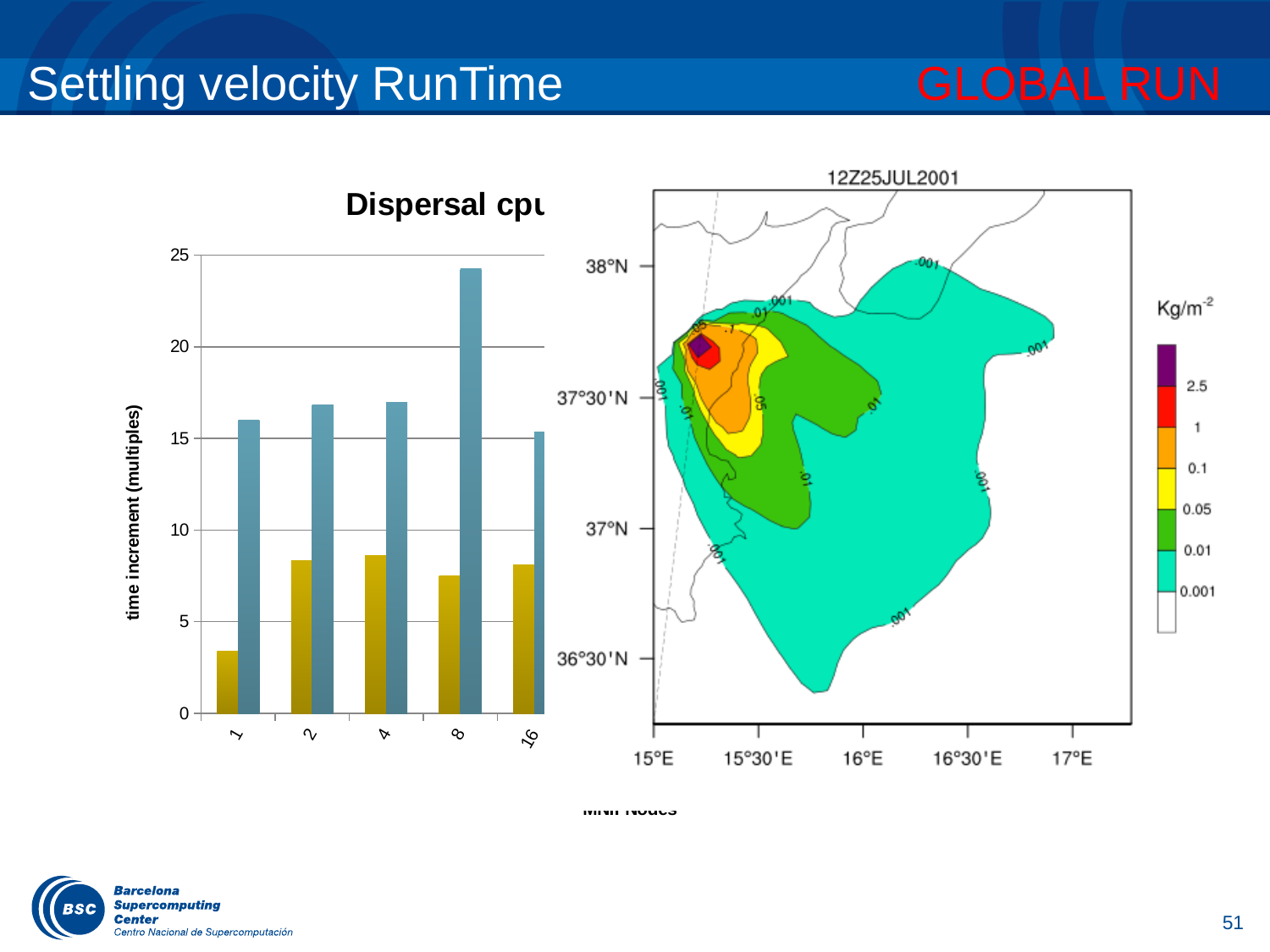
What is the label of the vertical axis of the bar chart? time increment (multiples) How many categories are shown on the x axis of the bar chart? 5 In the bar chart, for which category is the blue bar the tallest? 8 Is the gold bar for category 8 greater or less than 10? less In the bar chart, which gold bar is larger: category 1 or category 2? category 2 In the bar chart, for which category is the gold bar the shortest? 1 In the bar chart, which is larger for category 4: the blue bar or the gold bar? the blue bar Is the blue bar for category 8 greater or less than 20? greater What kind of chart is shown on the left of the slide? bar chart Is the gold bar for category 1 greater or less than 5? less In the bar chart, does the blue bar rise or fall from category 8 to category 16? fall